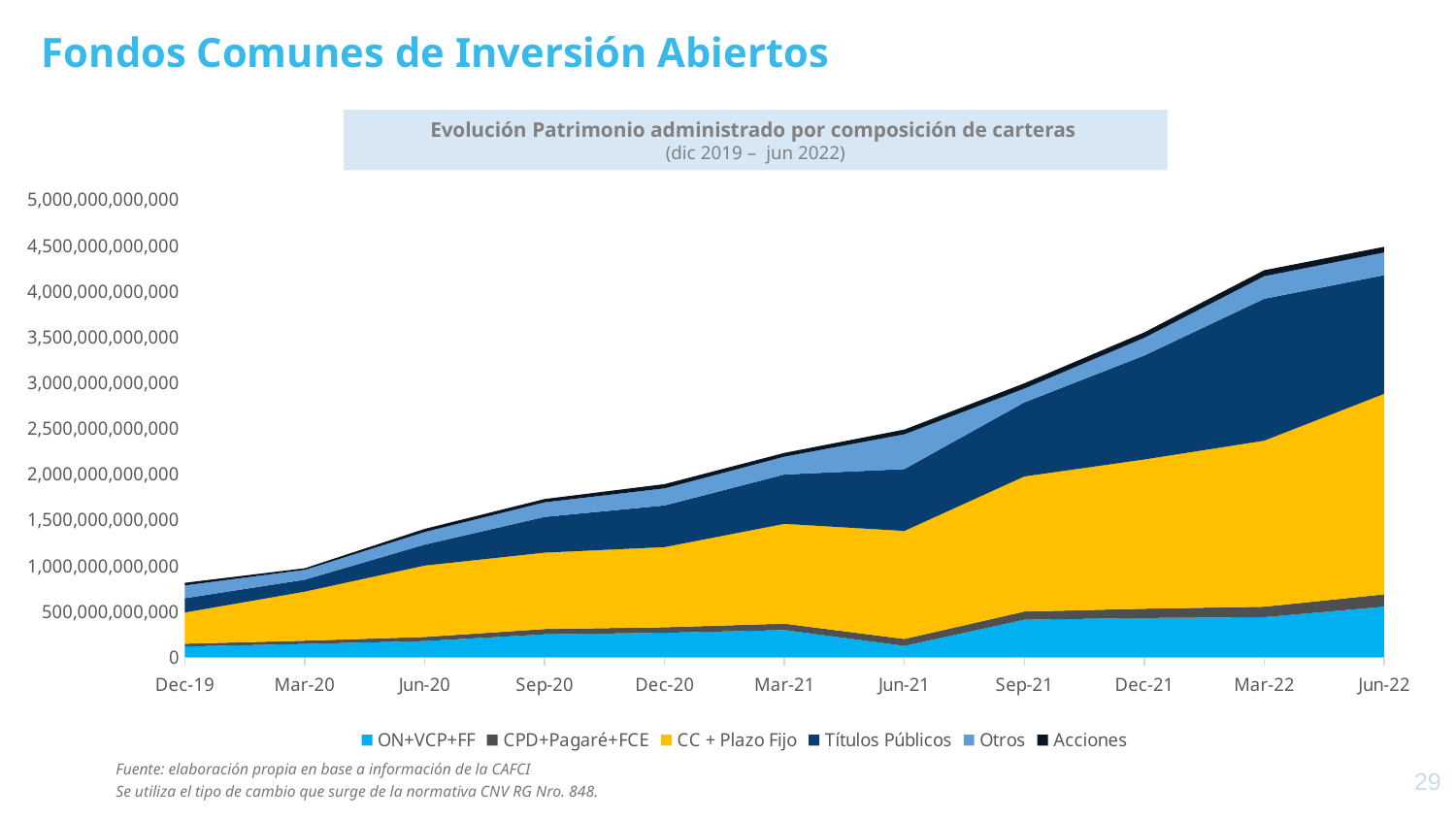
Is the total stacked value at Jun-22 greater or less than 4,000,000,000,000? greater Does the total administered patrimony rise or fall from Dec-19 to Jun-22? Rises What is the title of the chart? Evolución Patrimonio administrado por composición de carteras (dic 2019 – jun 2022) Is the total stacked value at Dec-19 greater or less than 1,000,000,000,000? less At which date is the total stacked value lowest? Dec-19 How many time points are shown along the x axis? 11 Which is larger, the total stacked value at Mar-22 or at Sep-21? Mar-22 Is the total stacked value at Jun-21 greater or less than 2,000,000,000,000? greater What kind of chart is shown on the slide? Stacked area chart How many series does the legend list? 6 Which series is shown in yellow? CC + Plazo Fijo At which date is the total stacked value highest? Jun-22